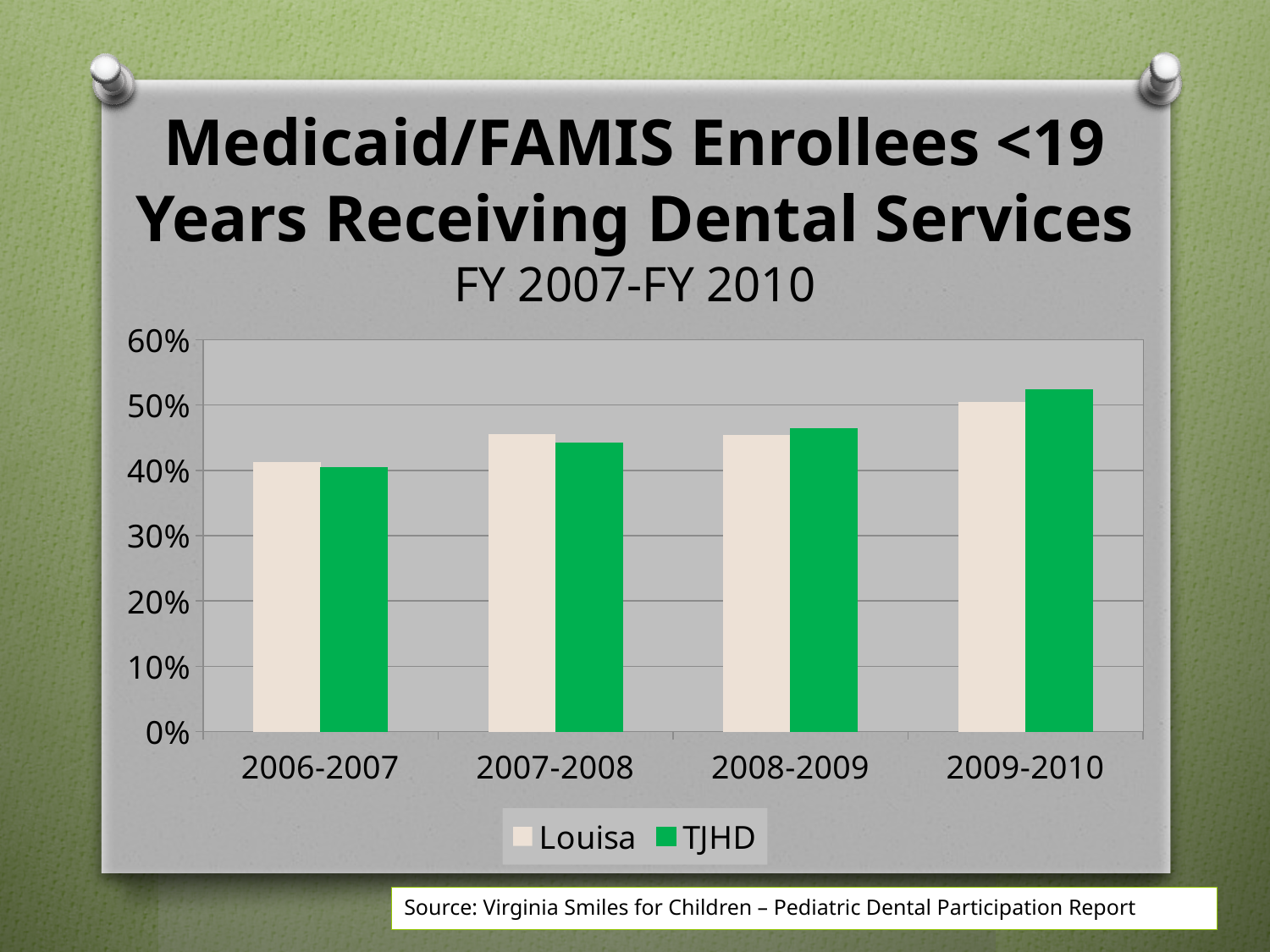
How many fiscal year categories are shown on the x axis? 4 Which two series are listed in the legend? Louisa and TJHD In which year is the TJHD value lowest? 2006-2007 Do the TJHD values rise or fall from 2006-2007 to 2009-2010? rise Is the TJHD value for 2008-2009 greater or less than 40%? greater In which year is the Louisa value lowest? 2006-2007 Is the TJHD value for 2009-2010 greater or less than 50%? greater Is the Louisa value for 2007-2008 greater or less than 50%? less In 2009-2010, which is larger, the Louisa value or the TJHD value? TJHD What kind of chart is shown on the slide? bar chart How many series does the legend list? 2 In which year is the TJHD value highest? 2009-2010